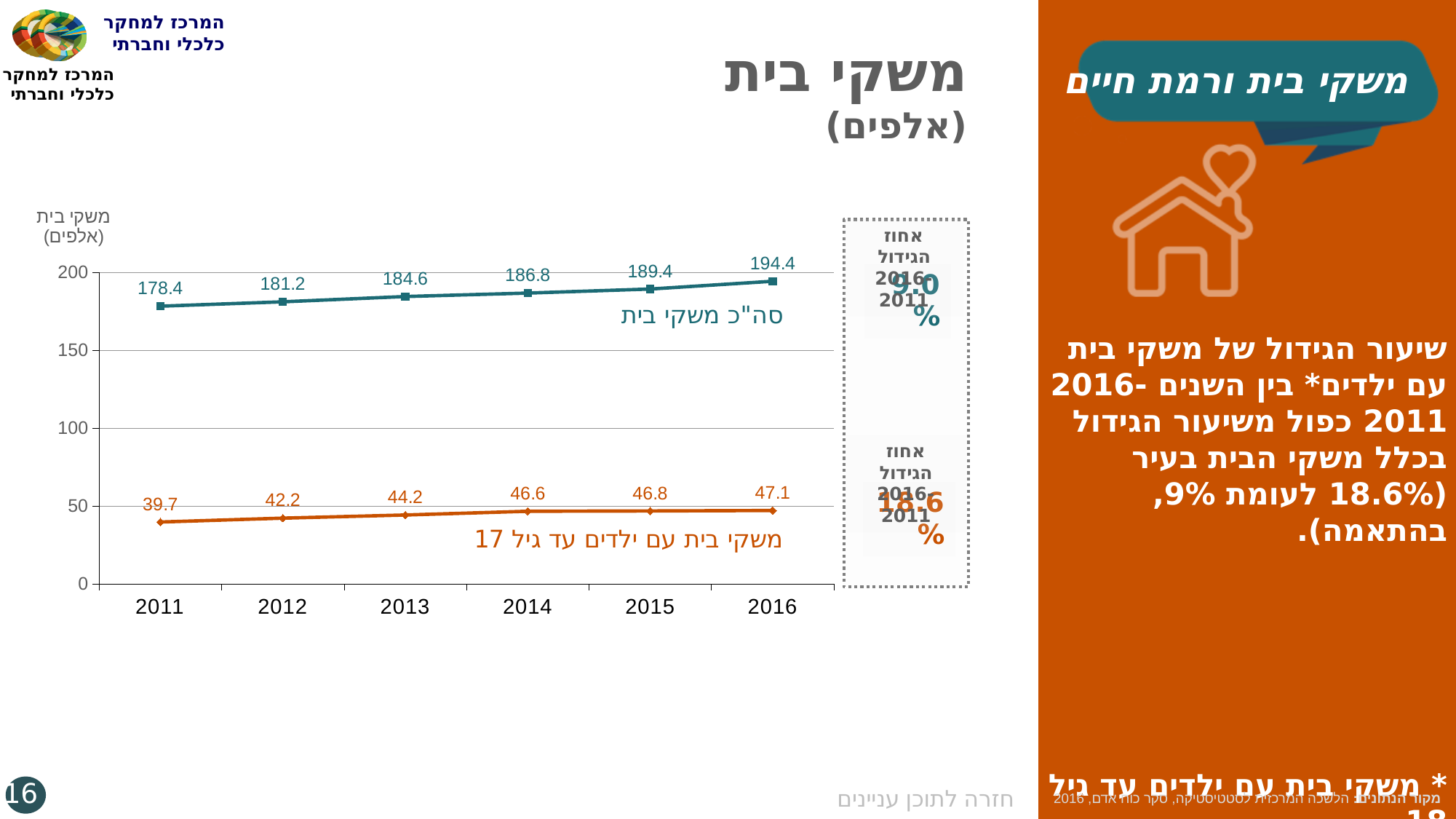
What is the difference between the סה"כ משקי בית values for 2016 and 2011? 16 In which year is the value for סה"כ משקי בית highest? 2016 What kind of chart is shown on the slide? Line chart What is the value for סה"כ משקי בית in 2013? 184.6 In which year is the value for משקי בית עם ילדים עד גיל 17 lowest? 2011 What is the value for סה"כ משקי בית in 2016? 194.4 Do the values for סה"כ משקי בית rise or fall from 2011 to 2016? Rise What is the value for משקי בית עם ילדים עד גיל 17 in 2011? 39.7 How many years are shown on the x axis? 6 What is the value for משקי בית עם ילדים עד גיל 17 in 2014? 46.6 What is the difference between the משקי בית עם ילדים עד גיל 17 values for 2012 and 2011? 2.5 Which is larger: the value for סה"כ משקי בית in 2015 or in 2012? 2015